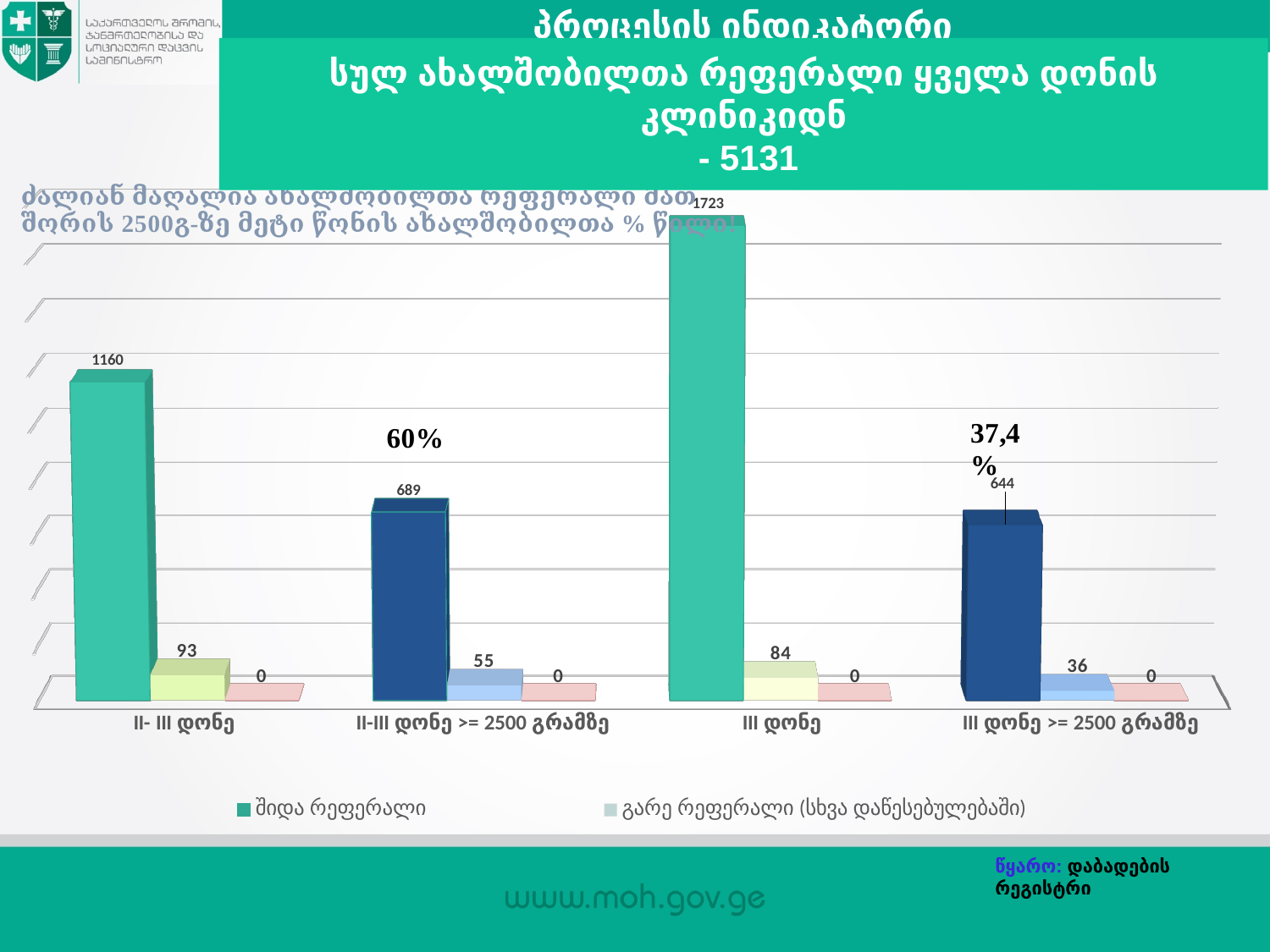
Which is larger: the შიდა რეფერალი value for II-III დონე >= 2500 გრამზე or for III დონე >= 2500 გრამზე? II-III დონე >= 2500 გრამზე Which category has the lowest value for გარე რეფერალი (სხვა დაწესებულებაში)? III დონე >= 2500 გრამზე What is the difference between the შიდა რეფერალი values for III დონე and II- III დონე? 563 What is the value of გარე რეფერალი (სხვა დაწესებულებაში) for III დონე >= 2500 გრამზე? 36 What is the value of გარე რეფერალი (სხვა დაწესებულებაში) for II-III დონე >= 2500 გრამზე? 55 What is the value of შიდა რეფერალი for II- III დონე? 1160 How many categories are shown on the x axis? 4 What kind of chart is shown on the slide? bar chart How many series does the legend list? 2 What is the value of შიდა რეფერალი for III დონე? 1723 Which category has the highest value for შიდა რეფერალი? III დონე What percentage label is shown above the II-III დონე >= 2500 გრამზე bar? 60%